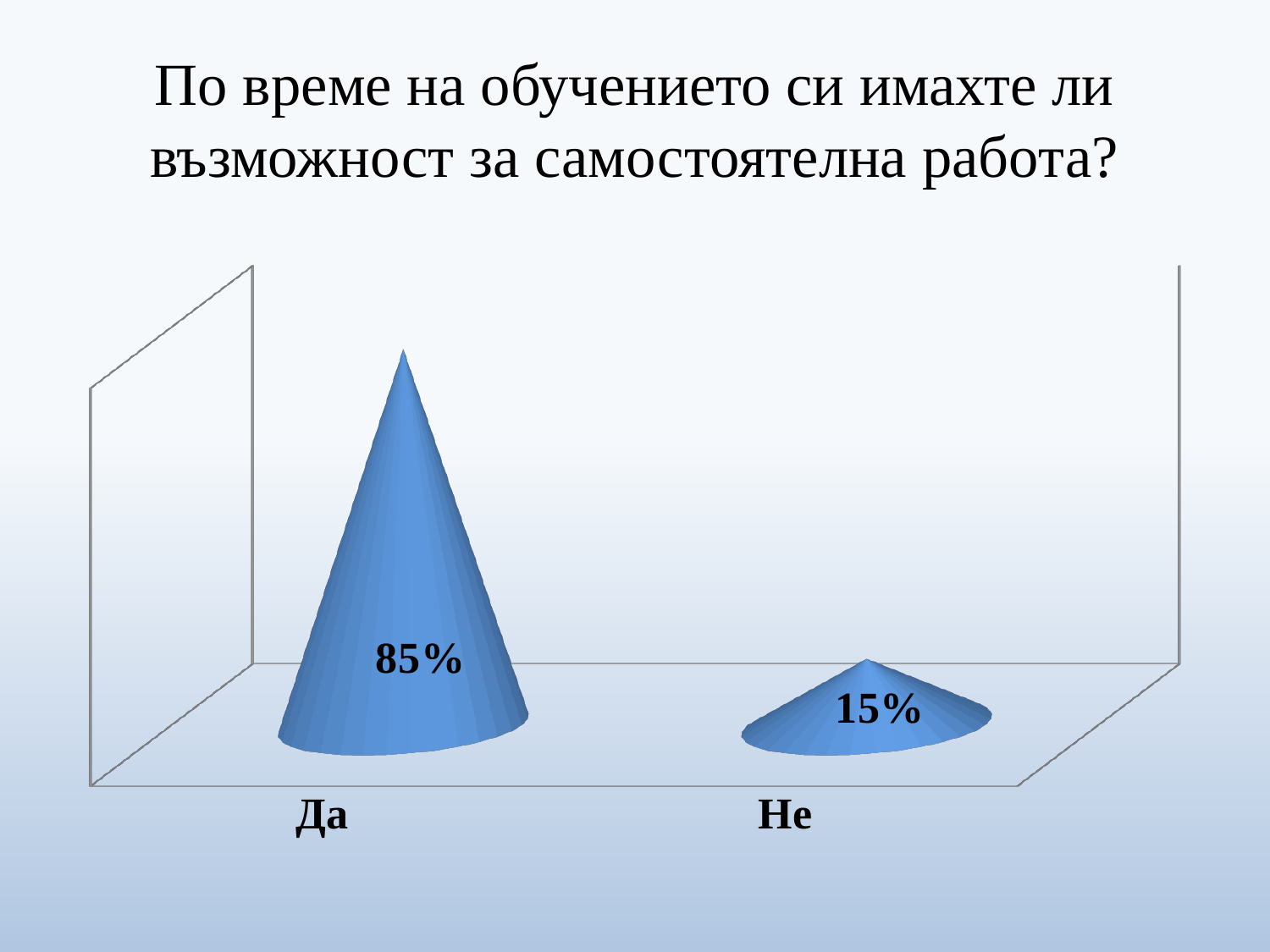
What is the difference between the values for Да and Не? 70% What is the total of the values for Да and Не? 100% How many categories are shown on the chart? 2 Which is larger, the value for Да or the value for Не? Да What colour are the bars on the chart? Blue What kind of chart is shown on the slide? Bar chart Which category has the lowest value? Не What is the value for Не? 15% Which category has the highest value? Да What is the value for Да? 85% What is the title of the slide? По време на обучението си имахте ли възможност за самостоятелна работа?